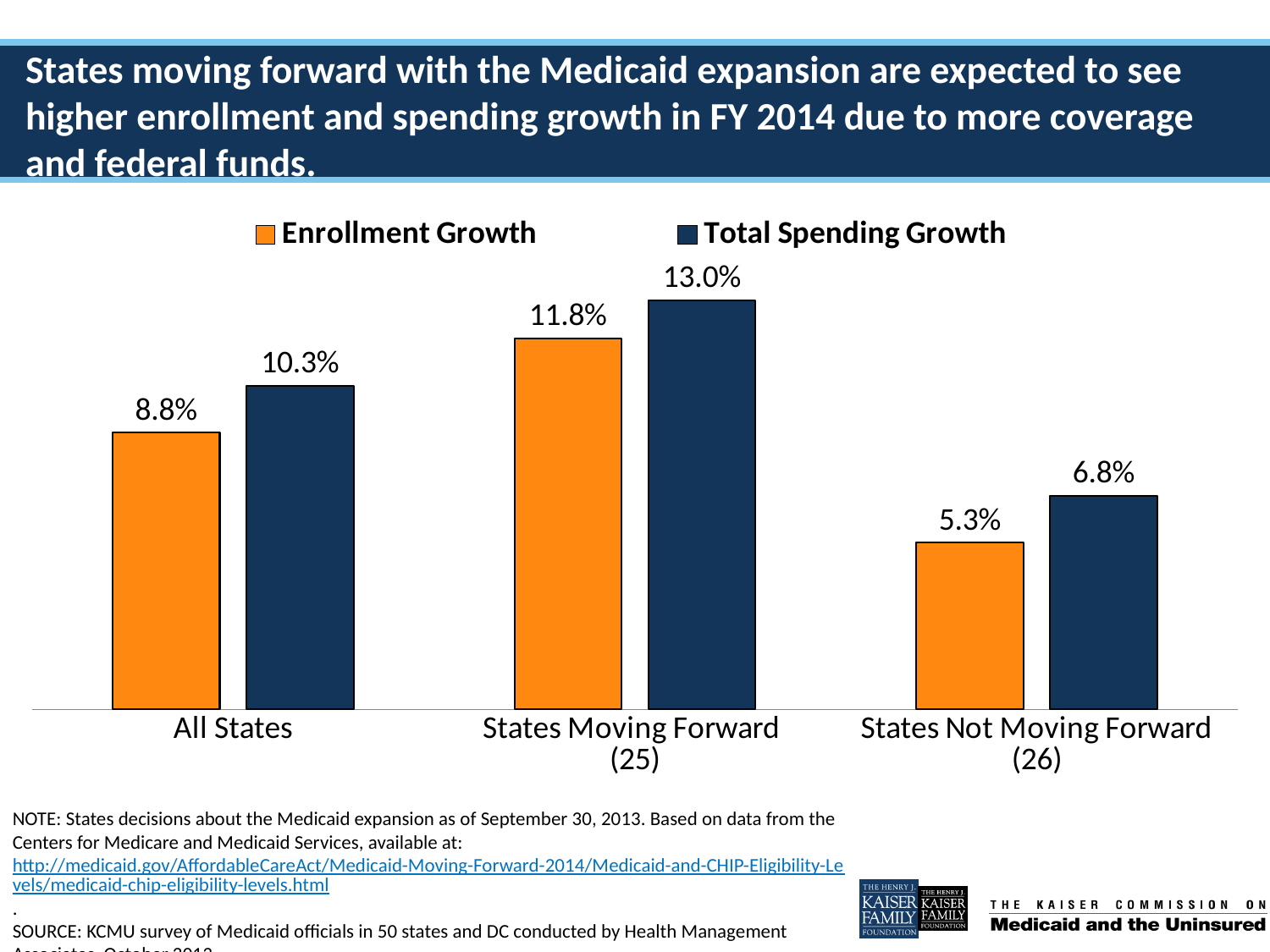
What is the difference in Enrollment Growth between States Moving Forward (25) and States Not Moving Forward (26)? 6.5% Which colour represents Total Spending Growth in the legend? Dark blue What kind of chart is shown on the slide? Bar chart What is the Enrollment Growth value for All States? 8.8% What is the Enrollment Growth value for States Not Moving Forward (26)? 5.3% How many series does the legend list? 2 How many categories are shown on the x axis? 3 What is the difference between Total Spending Growth and Enrollment Growth for All States? 1.5% Which category has the lowest Enrollment Growth? States Not Moving Forward (26) Which is larger: Enrollment Growth for States Moving Forward (25) or Total Spending Growth for All States? Enrollment Growth for States Moving Forward (25) What is the Total Spending Growth value for States Moving Forward (25)? 13.0% Which category has the highest Total Spending Growth? States Moving Forward (25)